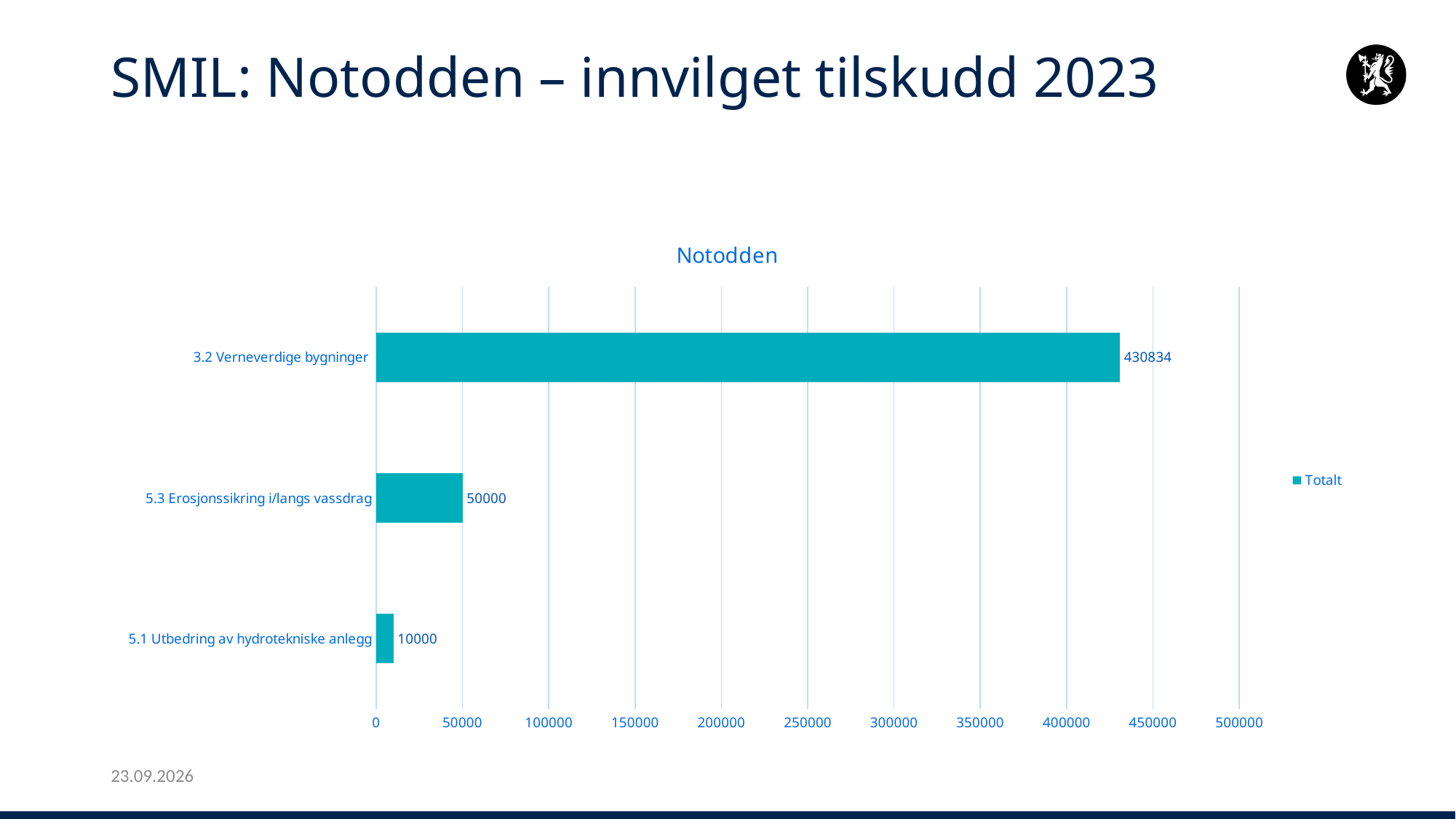
What is the value for 5.1 Utbedring av hydrotekniske anlegg? 10000 What is the difference between the values for 5.3 Erosjonssikring i/langs vassdrag and 5.1 Utbedring av hydrotekniske anlegg? 40000 Which category has the lowest value? 5.1 Utbedring av hydrotekniske anlegg How many series does the legend list? 1 What is the value for 5.3 Erosjonssikring i/langs vassdrag? 50000 Which category has the highest value? 3.2 Verneverdige bygninger What is the value for 3.2 Verneverdige bygninger? 430834 What is the difference between the values for 3.2 Verneverdige bygninger and 5.3 Erosjonssikring i/langs vassdrag? 380834 What kind of chart is shown on the slide? bar chart Is the value for 3.2 Verneverdige bygninger greater or less than 400000? greater Which is larger: the value for 5.3 Erosjonssikring i/langs vassdrag or 5.1 Utbedring av hydrotekniske anlegg? 5.3 Erosjonssikring i/langs vassdrag How many categories are shown in the chart? 3